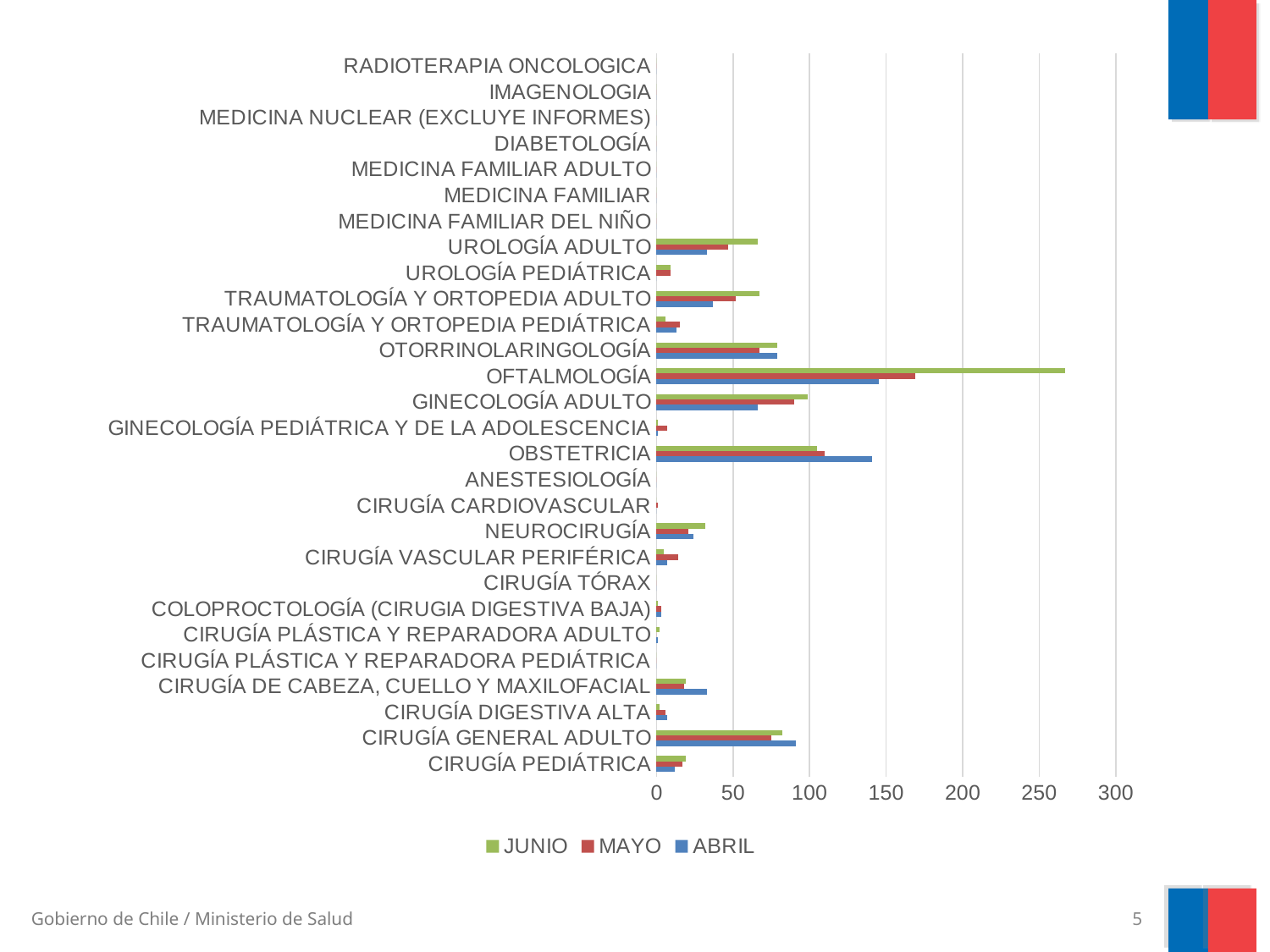
What kind of chart is shown on the slide? bar chart Which series are listed in the legend? JUNIO, MAYO, ABRIL How many series does the legend list? 3 Which category has the highest MAYO value? OFTALMOLOGÍA Which category has the highest JUNIO value? OFTALMOLOGÍA Is the ABRIL value for CIRUGÍA GENERAL ADULTO greater or less than 100? less How many categories are shown on the vertical axis? 28 Is the ABRIL value for OBSTETRICIA greater or less than 100? greater Is the JUNIO value for OFTALMOLOGÍA greater or less than 250? greater For OFTALMOLOGÍA, which is larger: the JUNIO value or the MAYO value? JUNIO For OBSTETRICIA, which is larger: the ABRIL value or the JUNIO value? ABRIL